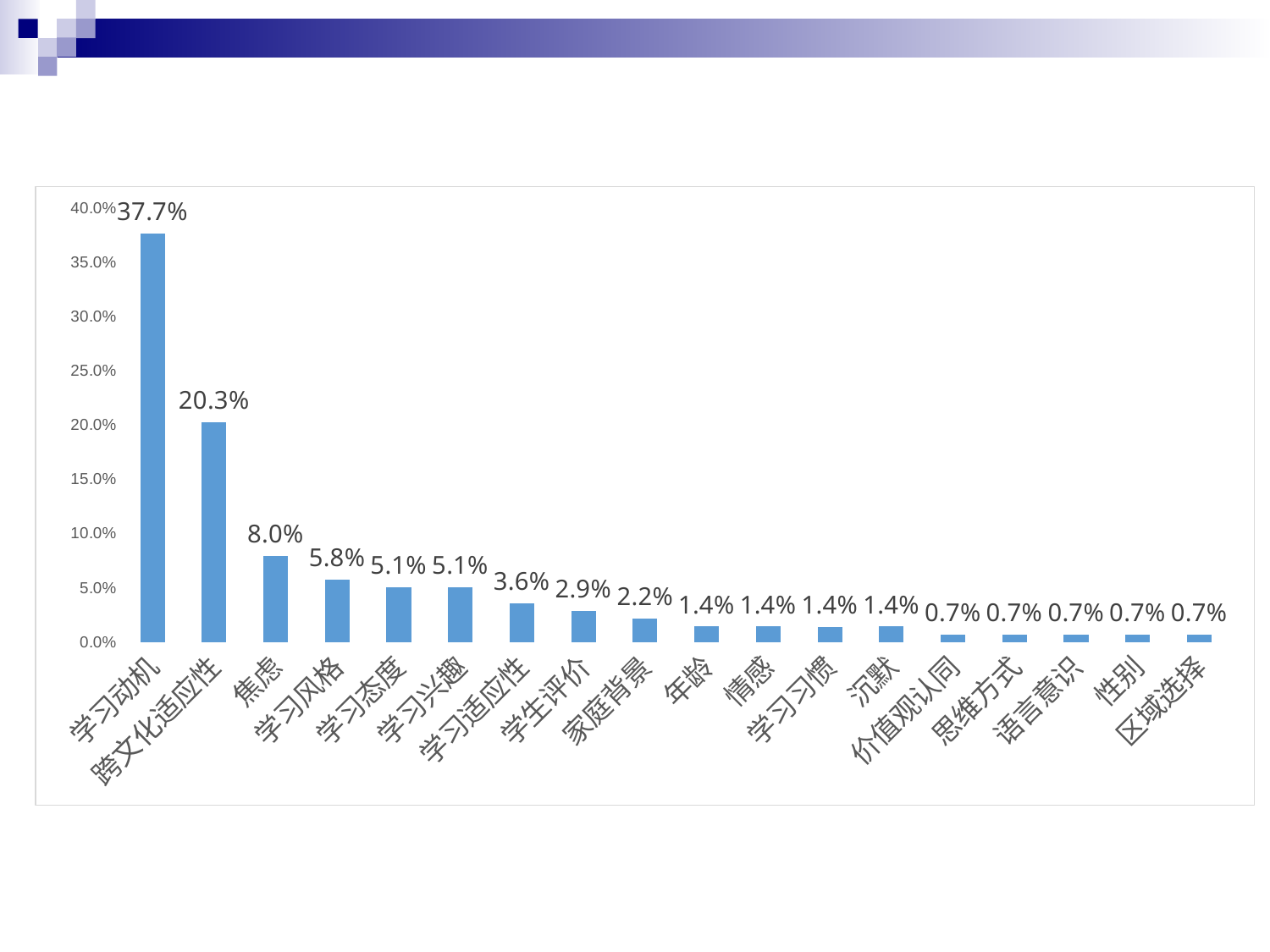
How many categories are shown on the x axis? 18 What is the value for 家庭背景? 2.2% What is the value for 学习动机? 37.7% What kind of chart is shown on the slide? bar chart Which is larger, the value for 学生评价 or the value for 年龄? 学生评价 What is the value for 焦虑? 8.0% What is the difference between the values for 学习动机 and 跨文化适应性? 17.4% What is the difference between the values for 焦虑 and 学习风格? 2.2% What is the value for 跨文化适应性? 20.3% Do the values rise or fall from left to right along the x axis? fall What is the value for 学习适应性? 3.6% Which category has the highest value? 学习动机